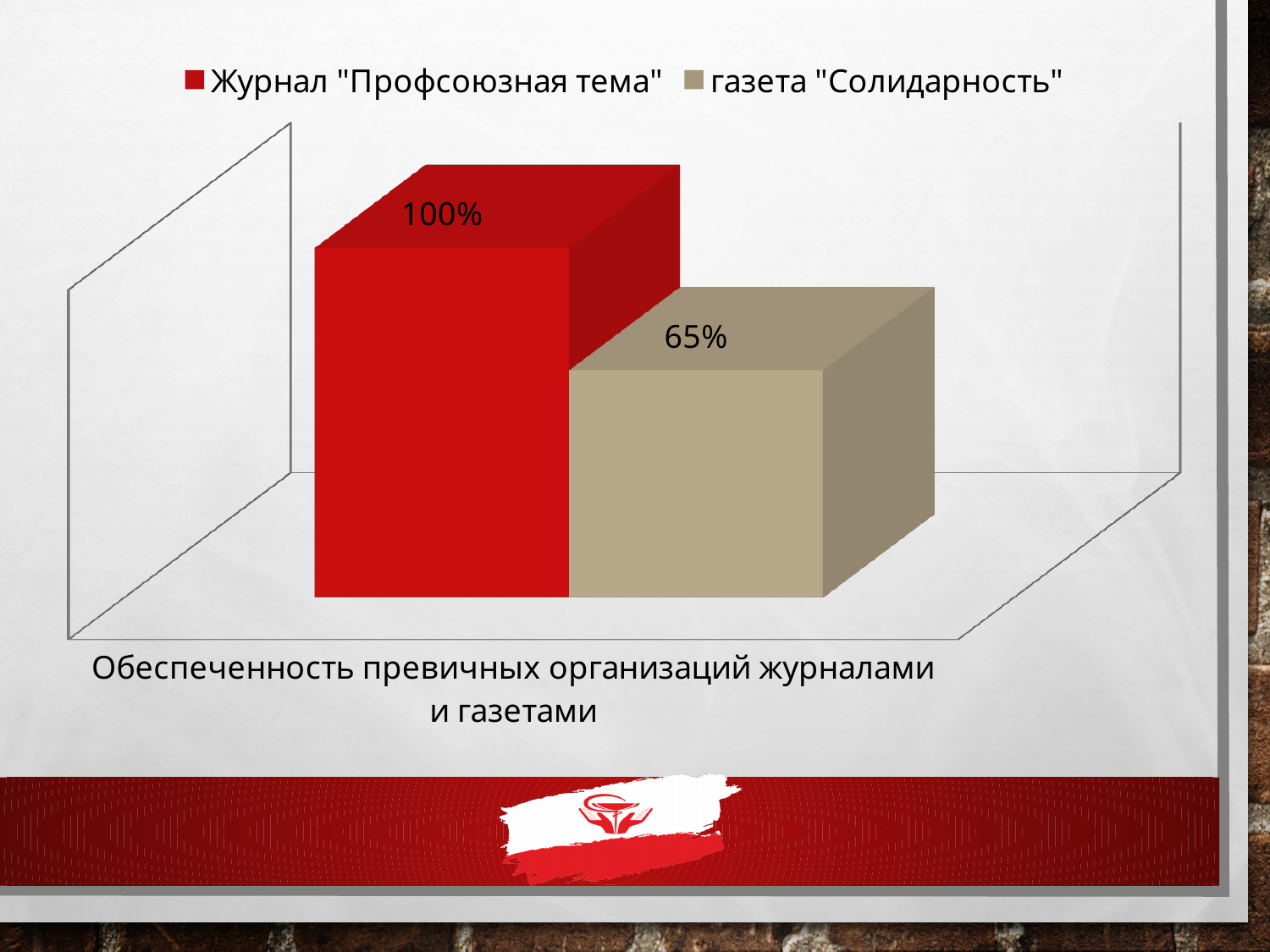
What is the title of the chart? Обеспеченность превичных организаций журналами и газетами What is the difference between the values for Журнал "Профсоюзная тема" and газета "Солидарность"? 35% How many series does the legend list? 2 Which series has the highest value? Журнал "Профсоюзная тема" What colour is the bar for Журнал "Профсоюзная тема"? Red How many bars are plotted on the chart? 2 What is the value for Журнал "Профсоюзная тема"? 100% What is the value for газета "Солидарность"? 65% What kind of chart is shown on the slide? Bar chart Which is larger: the value for Журнал "Профсоюзная тема" or for газета "Солидарность"? Журнал "Профсоюзная тема" Which series has the lowest value? газета "Солидарность"